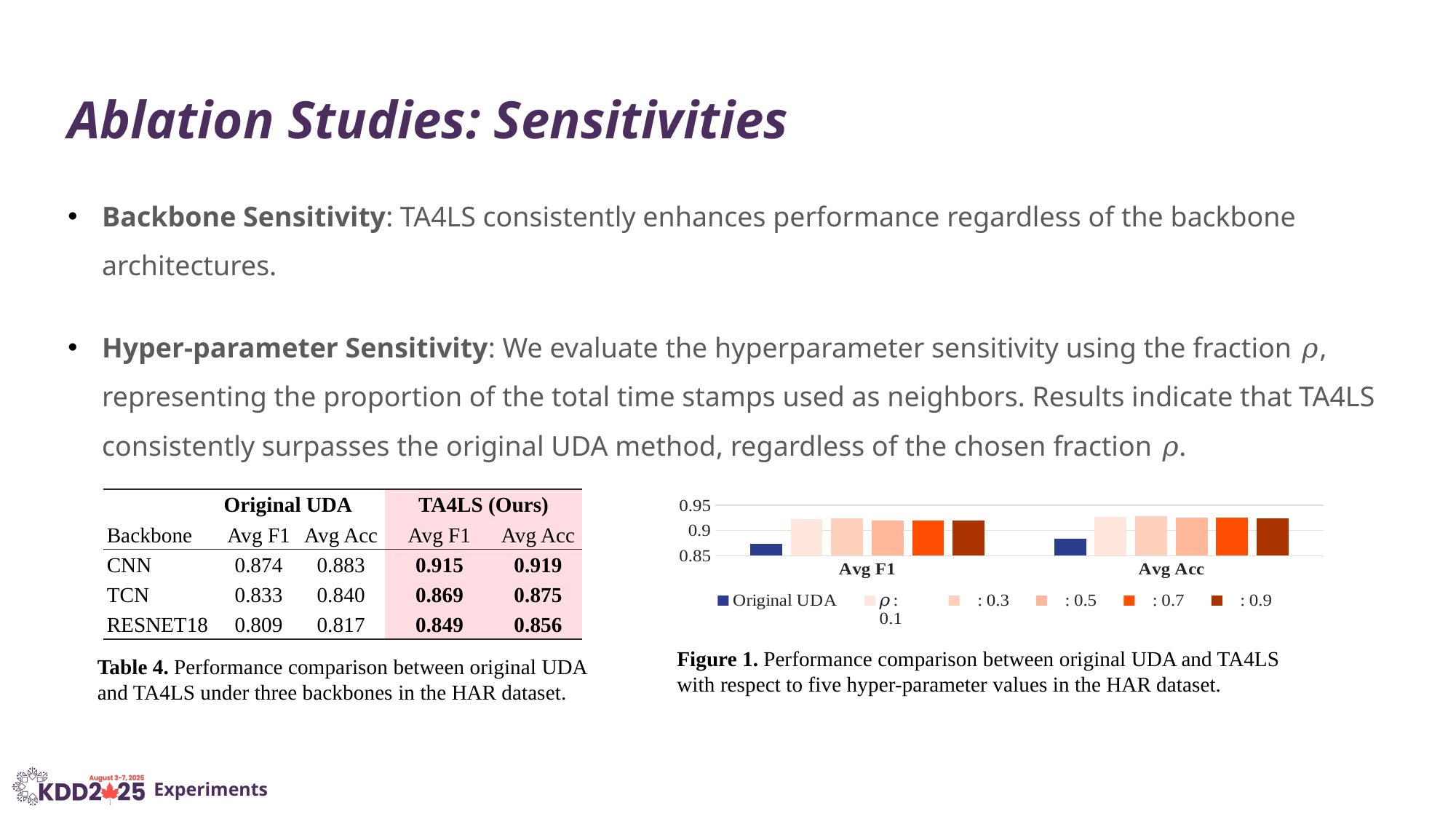
What kind of chart is Figure 1? bar chart How many series does the legend of Figure 1 list? 6 In Figure 1, is the Avg Acc value for ρ: 0.9 greater or less than 0.9? greater In Figure 1, is the Avg Acc value for Original UDA greater or less than 0.9? less In Figure 1, which series has the lowest Avg Acc value? Original UDA In Figure 1, is the Avg F1 value for ρ: 0.1 greater or less than 0.9? greater How many categories are shown on the x axis of Figure 1? 2 In Figure 1, which is larger for Avg F1: Original UDA or ρ: 0.7? ρ: 0.7 In Figure 1, which series has the lowest Avg F1 value? Original UDA In Figure 1, which is larger for Avg Acc: Original UDA or ρ: 0.5? ρ: 0.5 What are the two category labels on the x axis of Figure 1? Avg F1 and Avg Acc